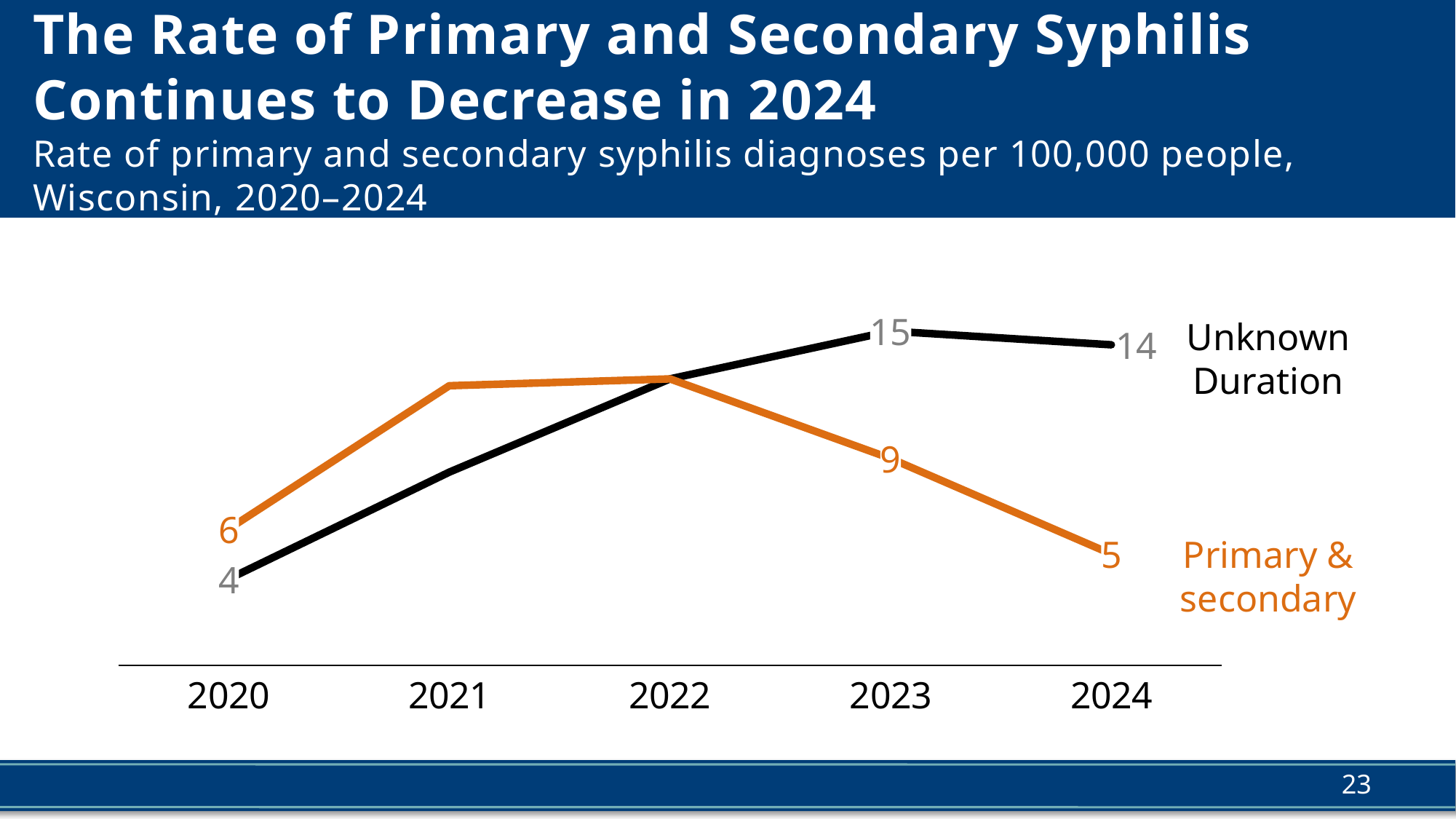
What is the Unknown Duration rate in 2020? 4 By how much did the Primary & secondary rate fall from 2023 to 2024? 4 In which year is the Unknown Duration rate highest? 2023 What kind of chart is shown on the slide? Line chart How many years are shown on the x axis? 5 What is the Unknown Duration rate in 2023? 15 How many series are plotted on the chart? 2 What is the Primary & secondary rate in 2020? 6 In which year is the Primary & secondary rate lowest? 2024 What is the Primary & secondary rate in 2024? 5 What is the difference between the Unknown Duration rate and the Primary & secondary rate in 2024? 9 In 2024, which series has the higher rate, Unknown Duration or Primary & secondary? Unknown Duration